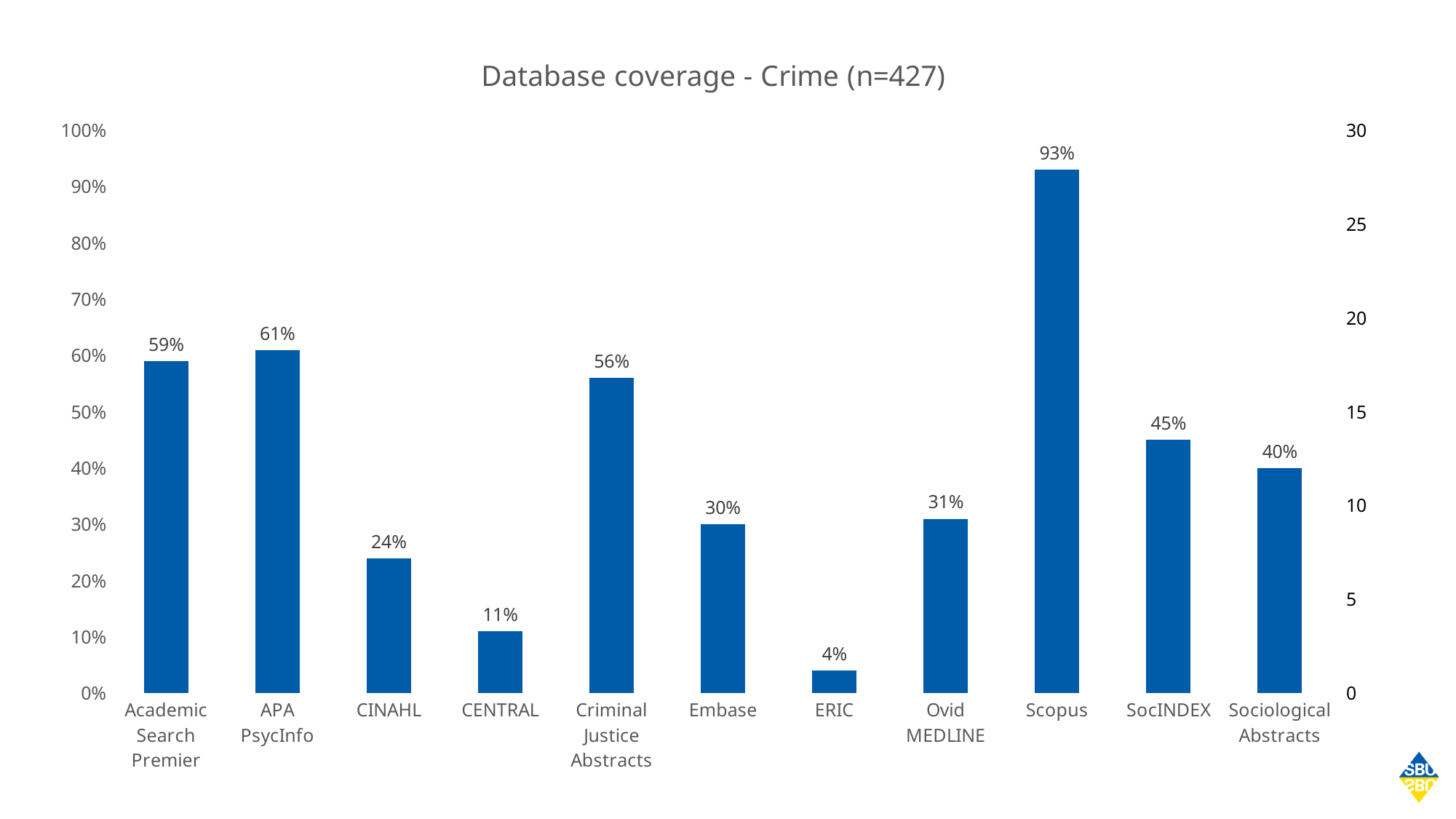
What kind of chart is shown on the slide? Bar chart Which database has the lowest coverage? ERIC What is the database coverage value for Ovid MEDLINE? 31% Which database has the highest coverage? Scopus What is the difference between the coverage of Scopus and SocINDEX? 48% How many databases are shown on the chart? 11 What is the difference between the coverage of APA PsycInfo and Academic Search Premier? 2% Is the value for Embase greater or less than 40%? less What is the database coverage value for CINAHL? 24% What is the database coverage value for Scopus? 93% What is the title of the chart? Database coverage - Crime (n=427) Which has higher coverage, Criminal Justice Abstracts or Sociological Abstracts? Criminal Justice Abstracts